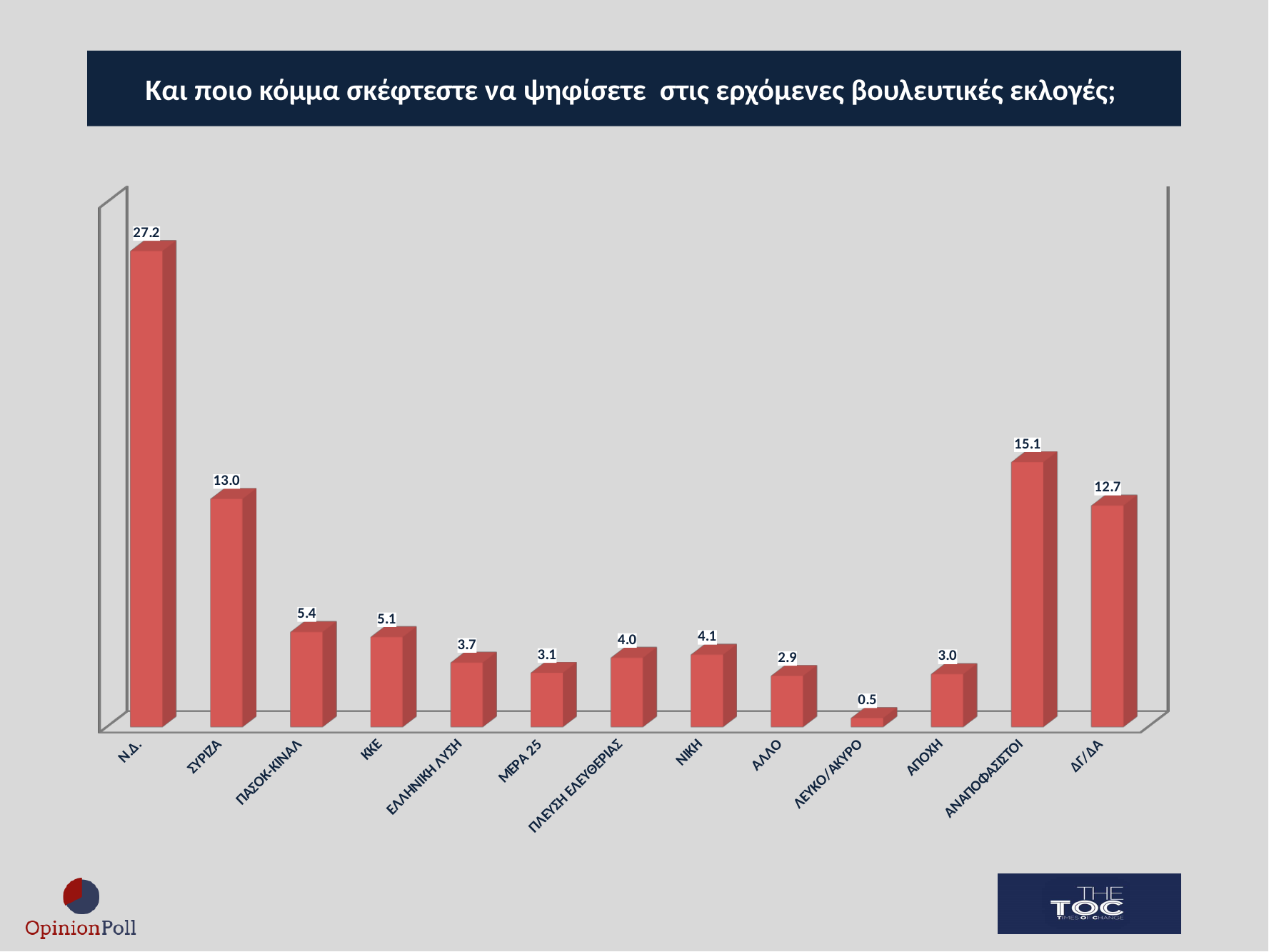
Which is larger, the value for ΠΑΣΟΚ-ΚΙΝΑΛ or the value for ΚΚΕ? ΠΑΣΟΚ-ΚΙΝΑΛ How many categories are shown on the x axis? 13 Which category has the lowest value? ΛΕΥΚΟ/ΑΚΥΡΟ Which category has the highest value? Ν.Δ. What is the value for ΑΝΑΠΟΦΑΣΙΣΤΟΙ? 15.1 What is the value for ΛΕΥΚΟ/ΑΚΥΡΟ? 0.5 What is the difference between the values for ΝΙΚΗ and ΠΛΕΥΣΗ ΕΛΕΥΘΕΡΙΑΣ? 0.1 What is the value for ΣΥΡΙΖΑ? 13.0 Which is larger, the value for ΑΝΑΠΟΦΑΣΙΣΤΟΙ or the value for ΔΓ/ΔΑ? ΑΝΑΠΟΦΑΣΙΣΤΟΙ What is the value for Ν.Δ.? 27.2 What kind of chart is shown on the slide? bar chart What is the difference between the values for Ν.Δ. and ΣΥΡΙΖΑ? 14.2